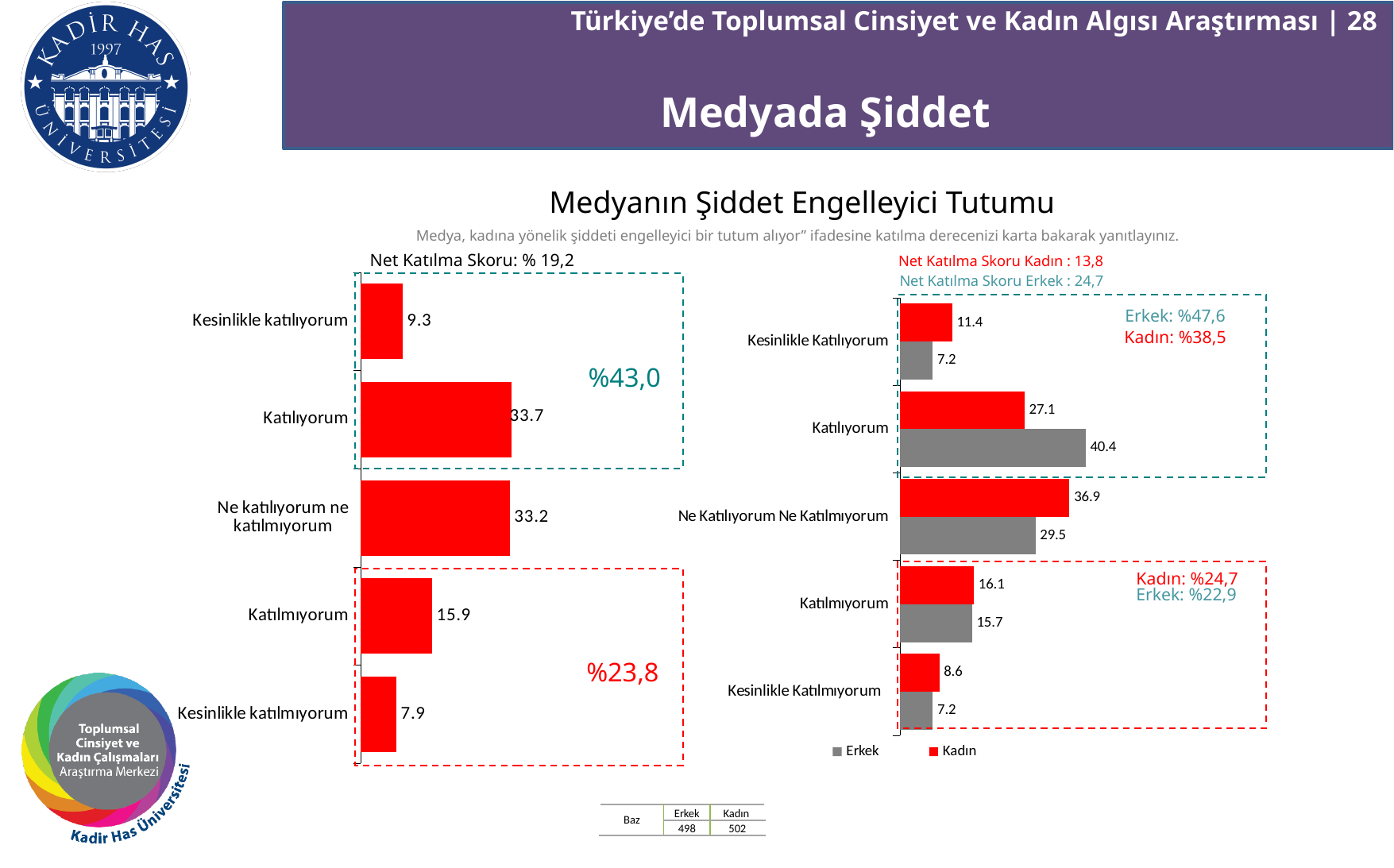
In the right chart (by gender), what is the Erkek value for Katılıyorum? 40.4 In the left chart (overall), what is the value for Katılıyorum? 33.7 In the left chart (overall), how many categories are shown? 5 In the left chart (overall), which category has the lowest value? Kesinlikle katılmıyorum In the left chart (overall), what is the value for Kesinlikle katılmıyorum? 7.9 In the right chart (by gender), which colour represents Kadın? Red In the right chart (by gender), what is the difference between the Erkek and Kadın values for Katılıyorum? 13.3 What type of chart is the left chart (overall)? Bar chart In the right chart (by gender), which is larger for Kesinlikle Katılıyorum: Erkek or Kadın? Kadın In the right chart (by gender), what is the Kadın value for Ne Katılıyorum Ne Katılmıyorum? 36.9 In the left chart (overall), what is the difference between Katılmıyorum and Kesinlikle katılıyorum? 6.6 In the right chart (by gender), how many series does the legend list? 2